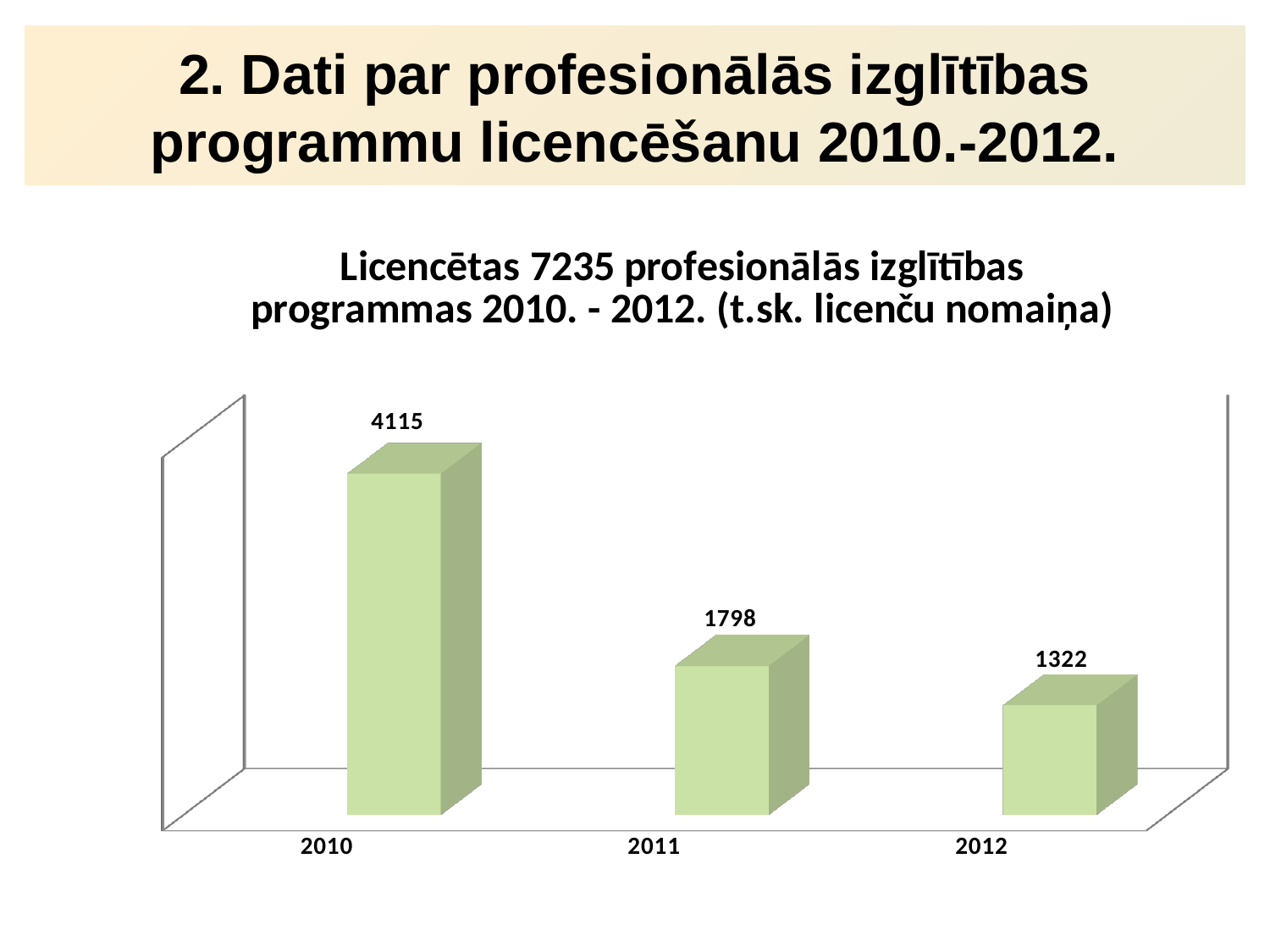
Do the values rise or fall from 2010 to 2012? fall Which year has the highest value? 2010 What is the value for 2010? 4115 What is the value for 2011? 1798 Which is larger, the value for 2011 or the value for 2012? 2011 What is the difference between the values for 2011 and 2012? 476 What is the difference between the values for 2010 and 2011? 2317 What is the value for 2012? 1322 How many years are shown on the x axis? 3 Which year has the lowest value? 2012 What kind of chart is shown? bar chart What is the total of the three values shown in the chart? 7235